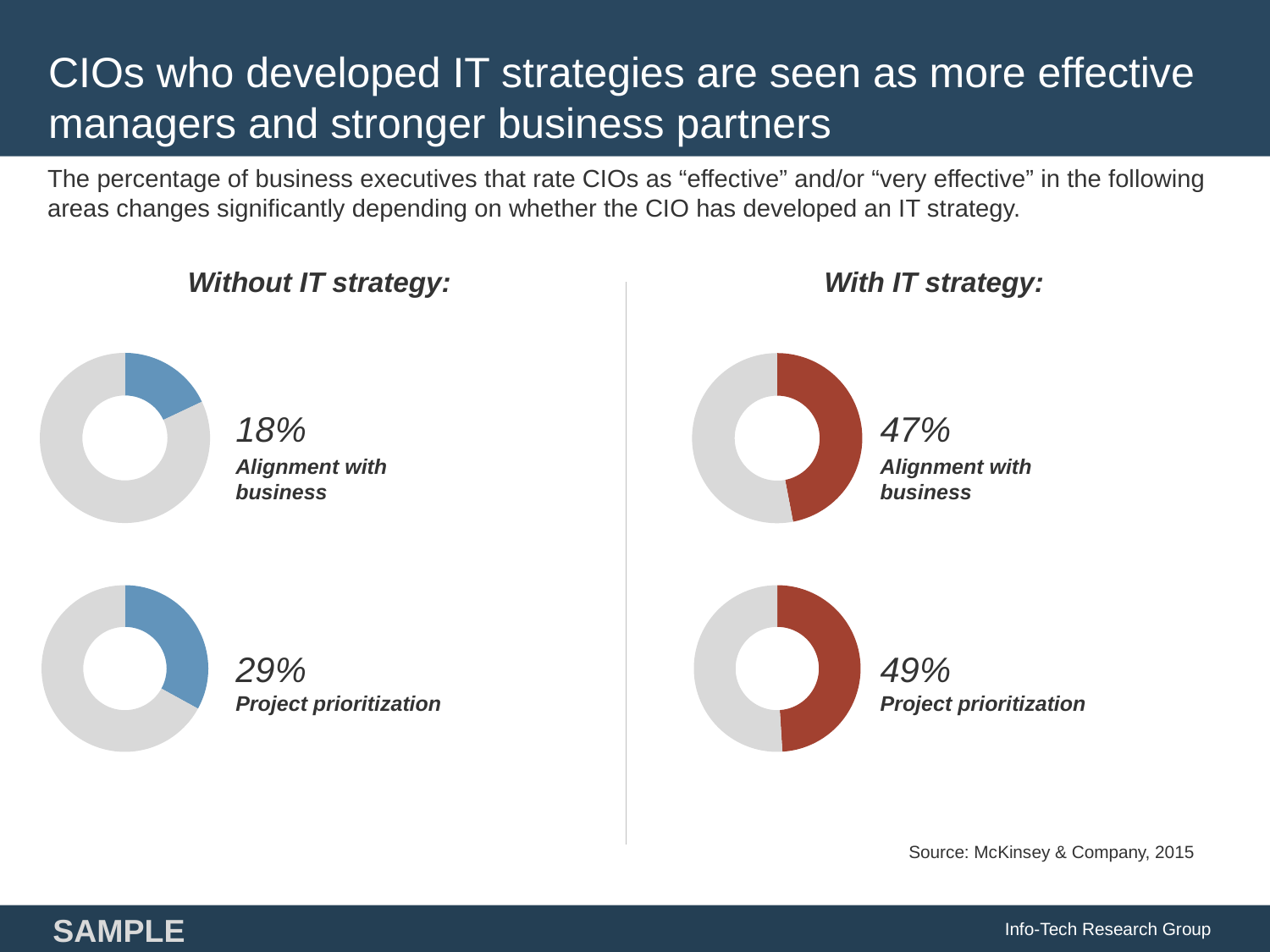
In the 'With IT strategy' section, what percentage is shown for Project prioritization? 49% In the 'Without IT strategy' section, what percentage is shown for Project prioritization? 29% How many donut charts are shown on the slide? 4 Of the four percentages shown, which chart has the highest value? Project prioritization, With IT strategy (49%) In the 'Without IT strategy' section, what percentage is shown for Alignment with business? 18% What is the difference between the Alignment with business percentages with and without an IT strategy? 29% Of the four percentages shown, which chart has the lowest value? Alignment with business, Without IT strategy (18%) What colour are the filled segments of the donut charts in the 'With IT strategy' section? Red What kind of chart is used to show each percentage on the slide? Donut chart What is the difference between the Project prioritization percentages with and without an IT strategy? 20% In the 'With IT strategy' section, what percentage is shown for Alignment with business? 47% Which is larger: the Alignment with business percentage without an IT strategy or with an IT strategy? With IT strategy